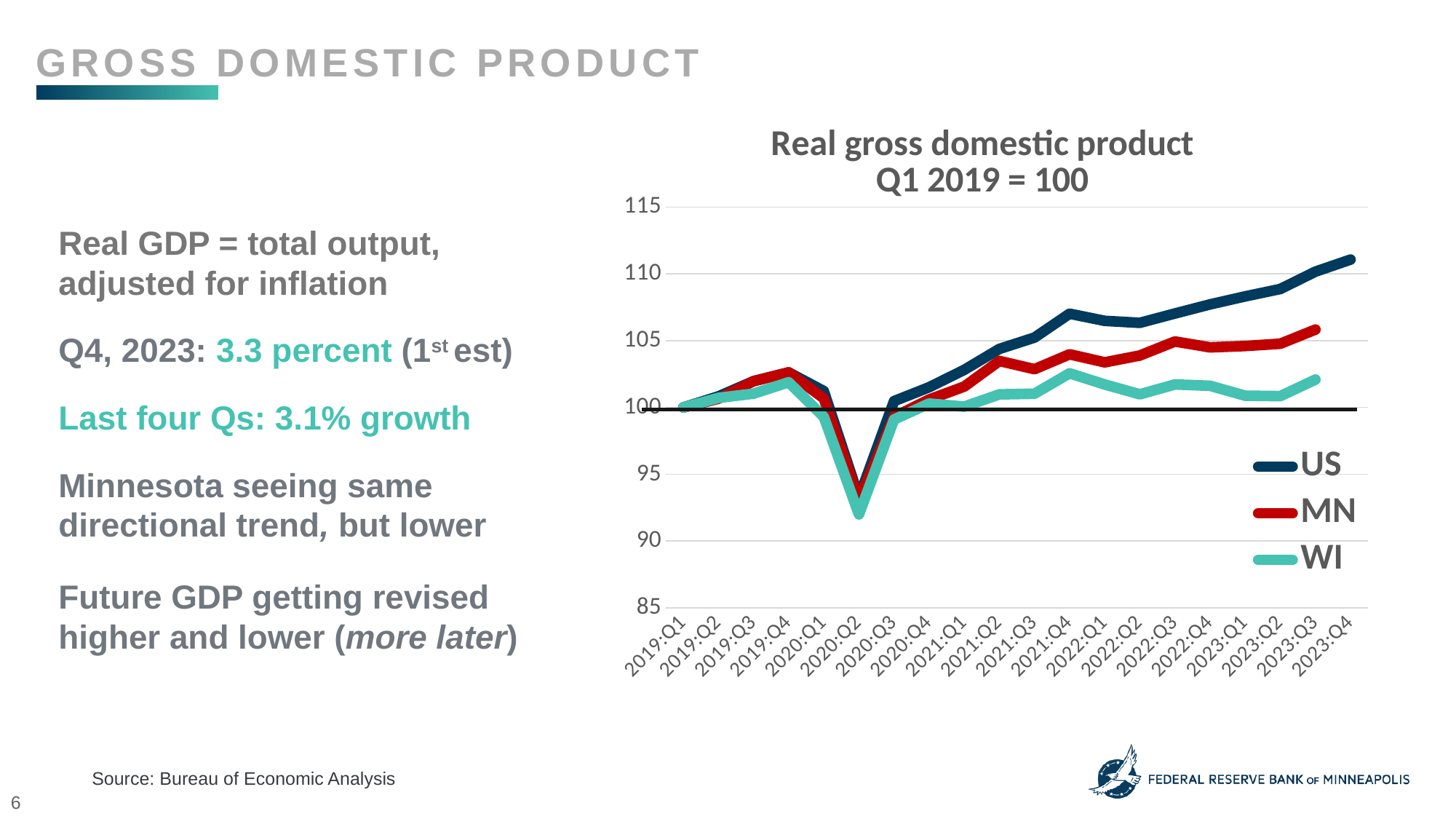
What is the index value of all three series at 2019:Q1? 100 Which series has the highest value at 2023:Q4? US How many quarters are shown along the x axis of the chart? 20 Is the value for WI at 2020:Q2 greater or less than 95? less Does the US series rise or fall from 2020:Q2 to 2023:Q4? rise What kind of chart is shown on the slide? line chart Which series has the lowest value at 2020:Q2? WI How many series does the chart legend list? 3 What is the title of the chart? Real gross domestic product Q1 2019 = 100 Is the value for US at 2023:Q4 greater or less than 110? greater